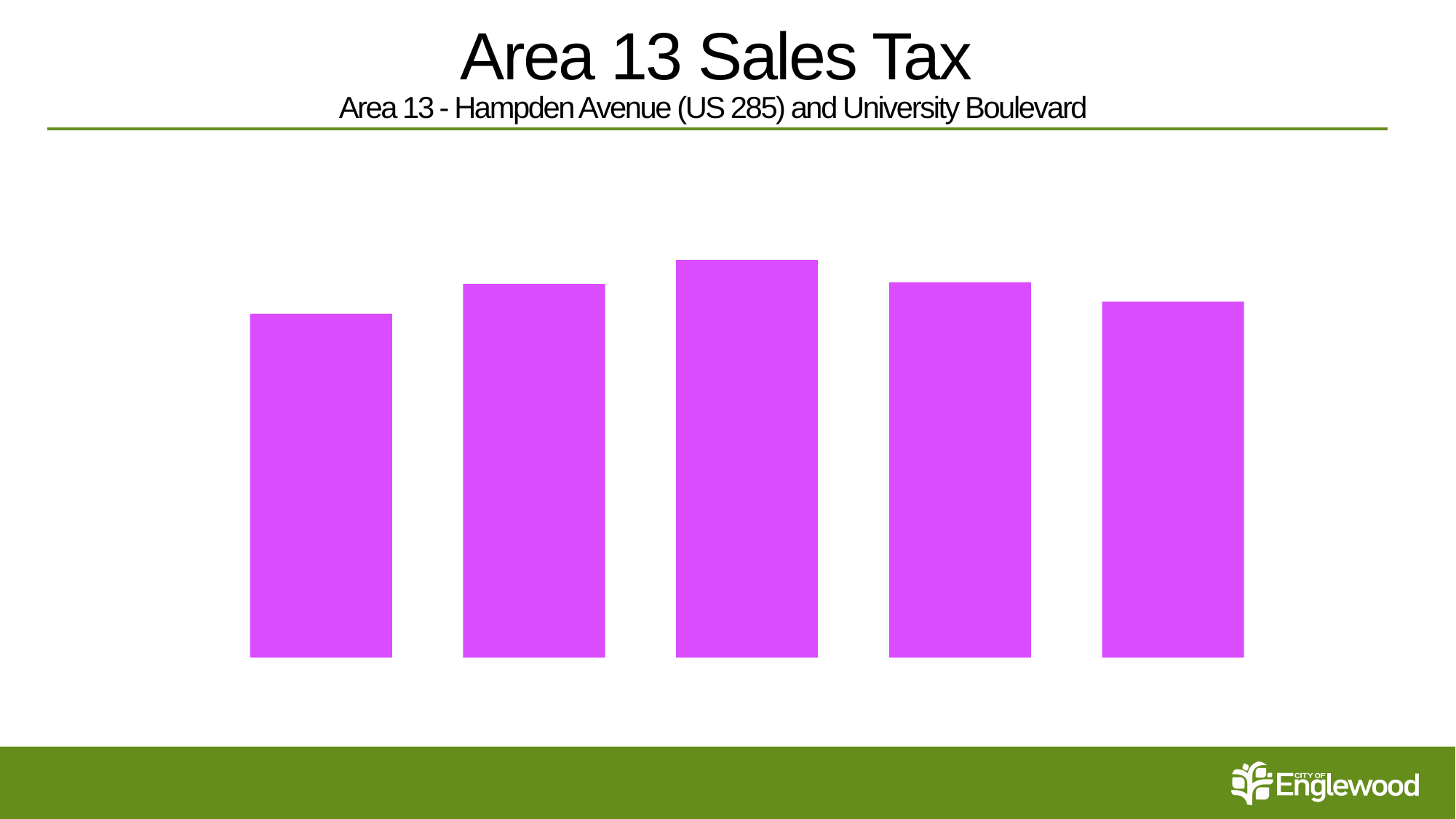
Is the third bar from the left taller or shorter than the first bar? taller Which bar is the shortest in the chart, counting from the left? the first bar Which bar is the tallest in the chart, counting from the left? the third bar What colour are the bars in the chart? purple How many bars does the chart show? 5 What kind of chart is shown on the slide? bar chart Is the fifth bar from the left taller or shorter than the second bar? shorter What is the title of the slide containing the chart? Area 13 Sales Tax Do the bars rise steadily from left to right, or do they rise and then fall? rise and then fall